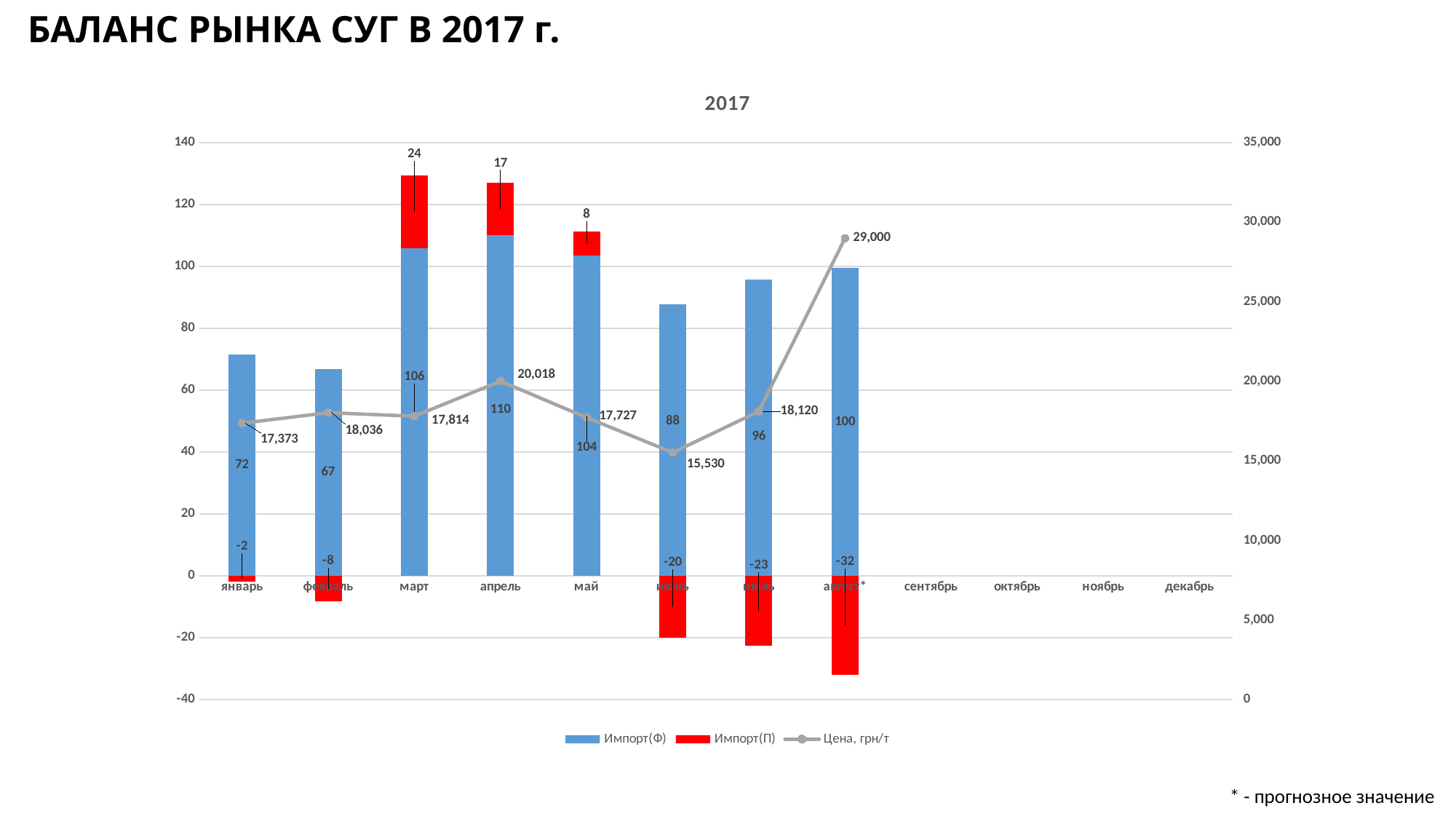
Which month has the highest Импорт(Ф) value? апрель What is the Импорт(П) value for март? 24 What is the difference between the Импорт(Ф) values for апрель and январь? 38 What is the Импорт(Ф) value for апрель? 110 Which is larger, the Цена, грн/т value for февраль or for март? февраль How many series does the legend list? 3 Which month has the lowest Импорт(Ф) value? февраль What is the Цена, грн/т value for август*? 29,000 What is the total of the stacked bar for март (Импорт(Ф) plus Импорт(П))? 130 Which month has the lowest Цена, грн/т value? июнь What is the Цена, грн/т value for июнь? 15,530 What is the title shown above the plot area of the chart? 2017